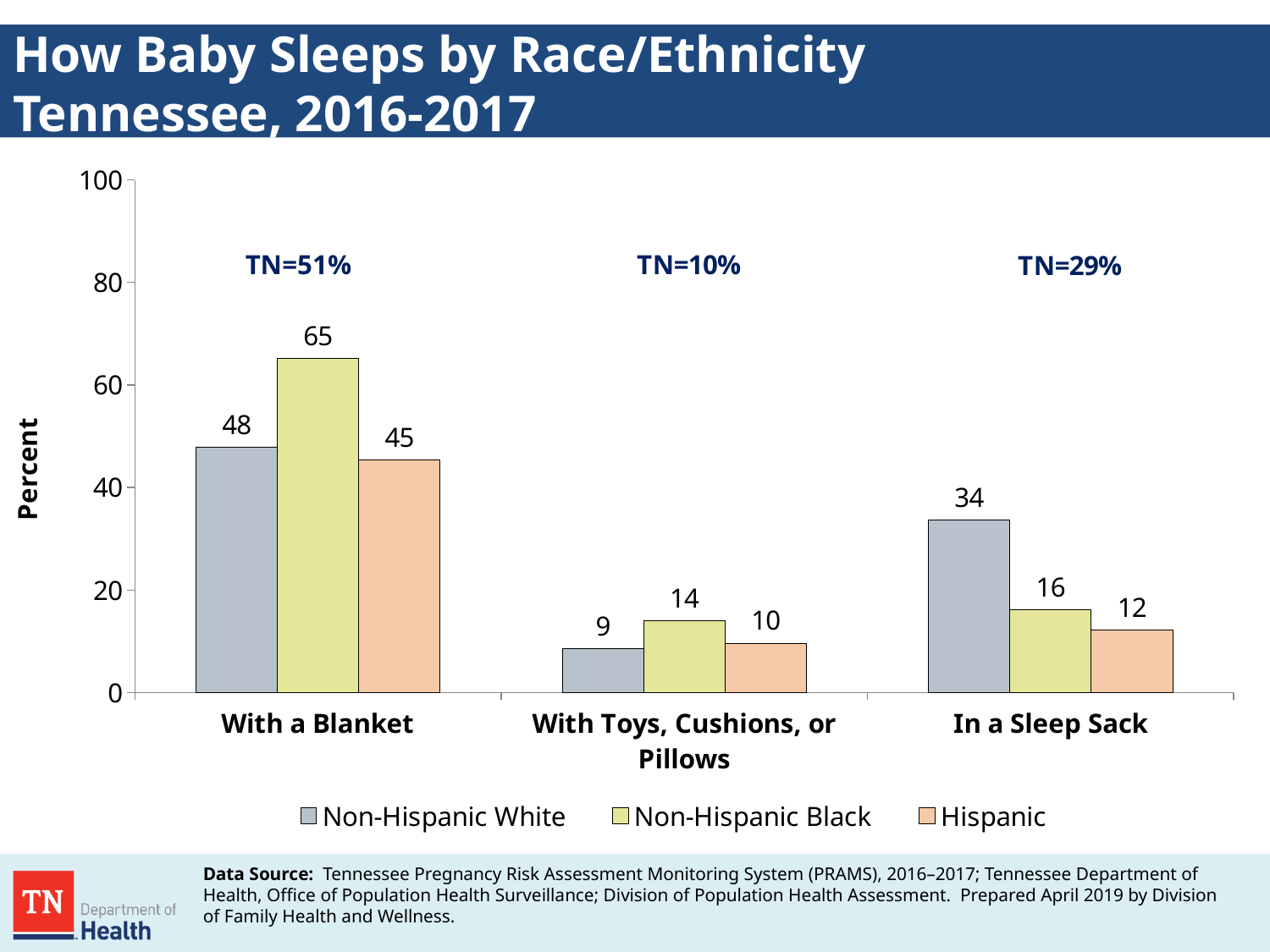
How many sleep categories are shown on the x axis? 3 Which race/ethnicity group has the highest value for 'In a Sleep Sack'? Non-Hispanic White Which is larger: the Non-Hispanic Black value for 'In a Sleep Sack' or the Hispanic value for 'In a Sleep Sack'? Non-Hispanic Black What is the label on the y axis? Percent What is the value for Hispanic babies in the 'In a Sleep Sack' category? 12 How many series does the legend list? 3 What kind of chart is shown on the slide? Bar chart What is the value for Non-Hispanic White babies in the 'With Toys, Cushions, or Pillows' category? 9 What is the Tennessee overall percentage shown above the 'With Toys, Cushions, or Pillows' category? TN=10% What is the difference between the Non-Hispanic Black and Non-Hispanic White values for 'With a Blanket'? 17 What percent of Non-Hispanic Black babies sleep with a blanket? 65 Which race/ethnicity group has the lowest value for 'With a Blanket'? Hispanic